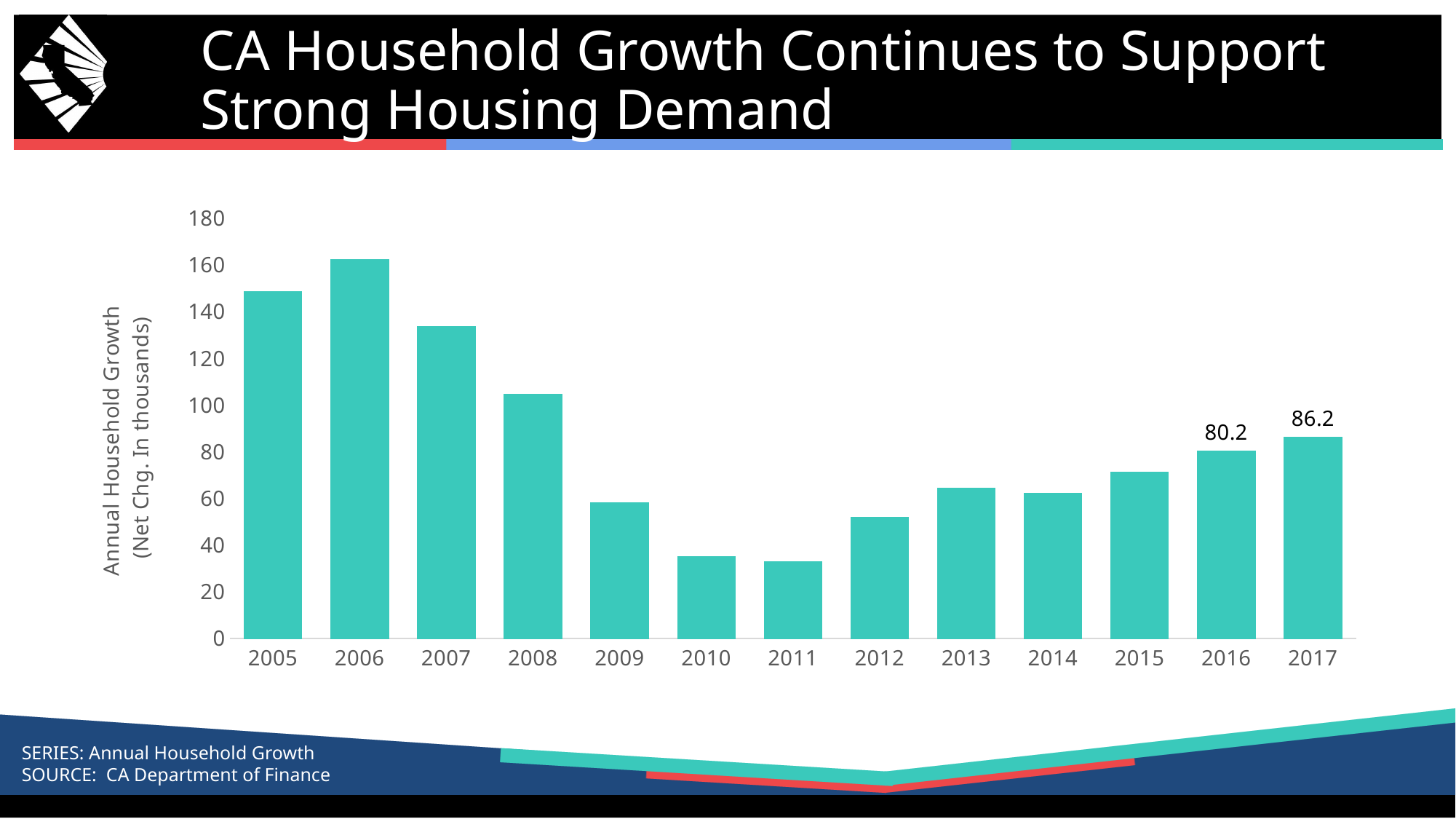
Is the value for 2008 greater or less than 100? greater What is the value for 2017? 86.2 How many years are shown on the x axis? 13 Do the values rise or fall from 2006 to 2011? fall What is the difference between the values for 2017 and 2016? 6.0 What is the label of the vertical axis? Annual Household Growth (Net Chg. In thousands) Which year has the lowest annual household growth? 2011 Which is larger, the value for 2005 or the value for 2007? 2005 Is the value for 2010 greater or less than 40? less Which year has the highest annual household growth? 2006 What is the value for 2016? 80.2 What kind of chart is shown on the slide? bar chart